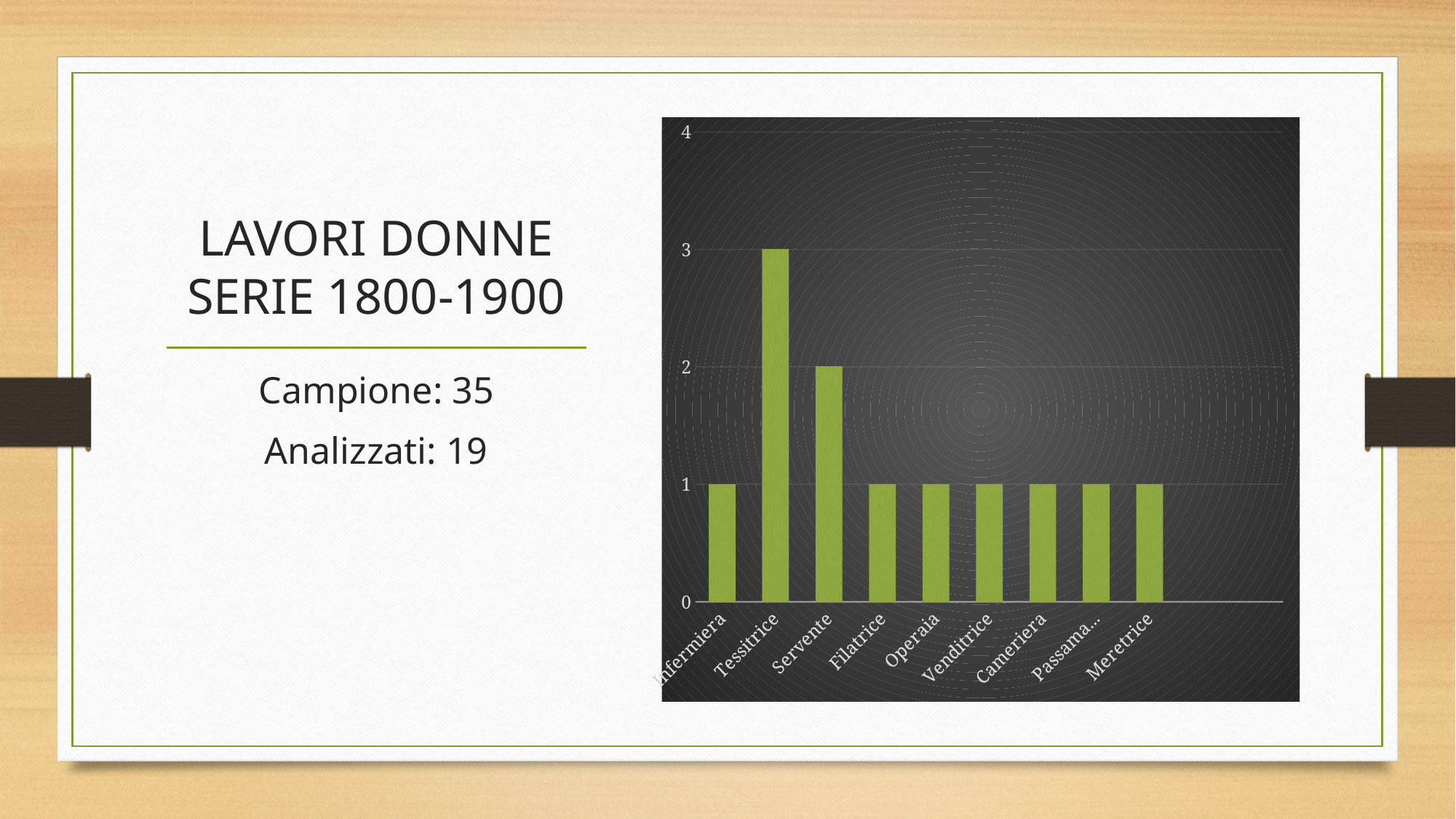
How many categories are shown on the x axis? 9 Which is larger, the value for Tessitrice or the value for Servente? Tessitrice What is the value for Servente? 2 Which category has the highest value? Tessitrice What is the value for Meretrice? 1 What kind of chart is shown on the slide? bar chart What is the highest value shown on the vertical axis? 4 Is the value for Tessitrice greater or less than 2? greater What is the difference between the values for Tessitrice and Servente? 1 What is the difference between the values for Servente and Filatrice? 1 What is the value for Tessitrice? 3 What is the value for Infermiera? 1